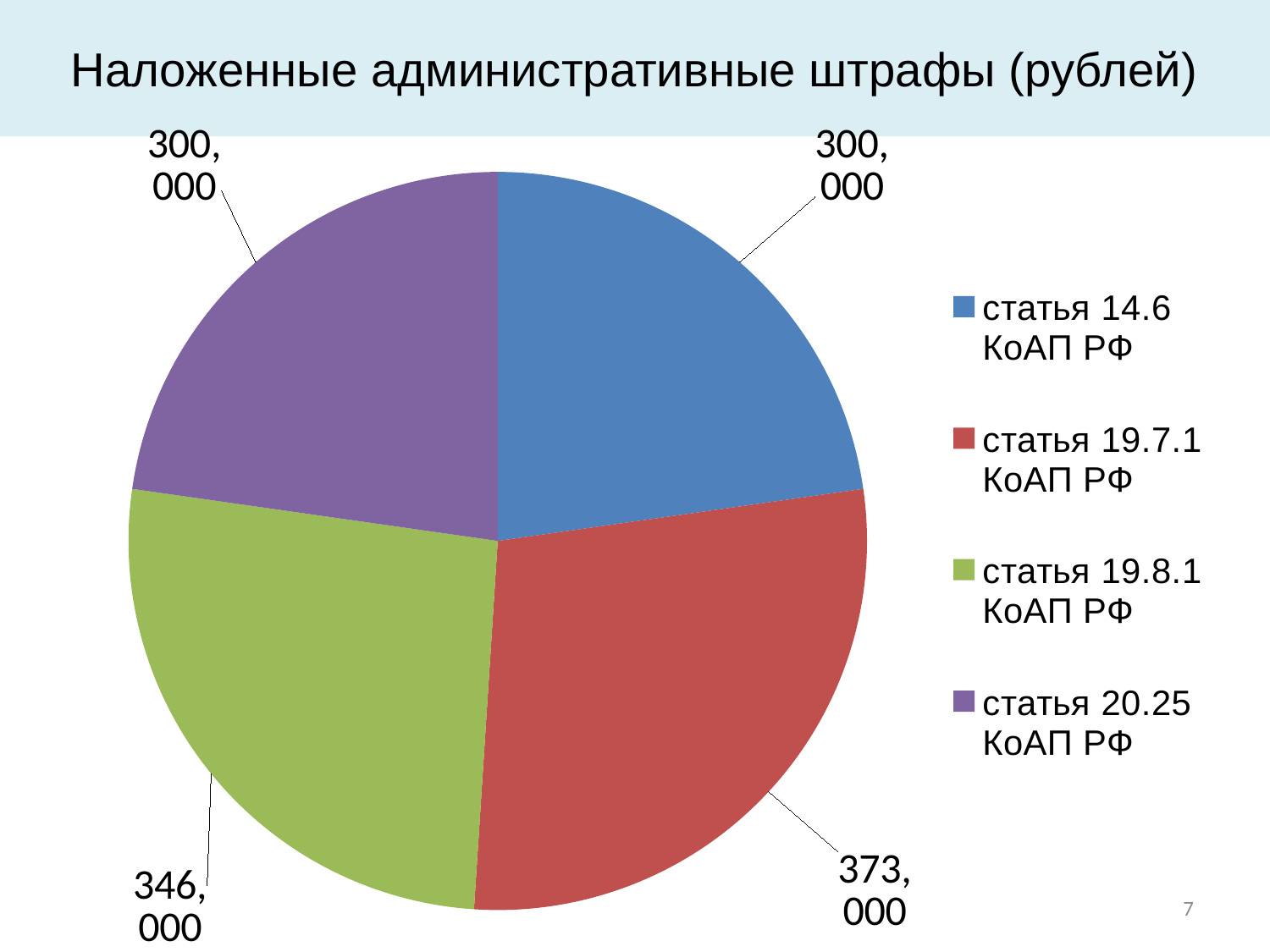
What is the difference between the values for статья 19.8.1 КоАП РФ and статья 20.25 КоАП РФ? 46,000 What kind of chart is shown on the slide? pie chart What is the value for статья 20.25 КоАП РФ? 300,000 What is the value for статья 19.7.1 КоАП РФ? 373,000 How many slices does the pie chart have? 4 Which category has the highest value? статья 19.7.1 КоАП РФ What is the difference between the values for статья 19.7.1 КоАП РФ and статья 19.8.1 КоАП РФ? 27,000 Which is larger, the value for статья 19.7.1 КоАП РФ or статья 14.6 КоАП РФ? статья 19.7.1 КоАП РФ What is the value for статья 14.6 КоАП РФ? 300,000 What is the value for статья 19.8.1 КоАП РФ? 346,000 How many entries does the legend list? 4 What is the title of the chart? Наложенные административные штрафы (рублей)